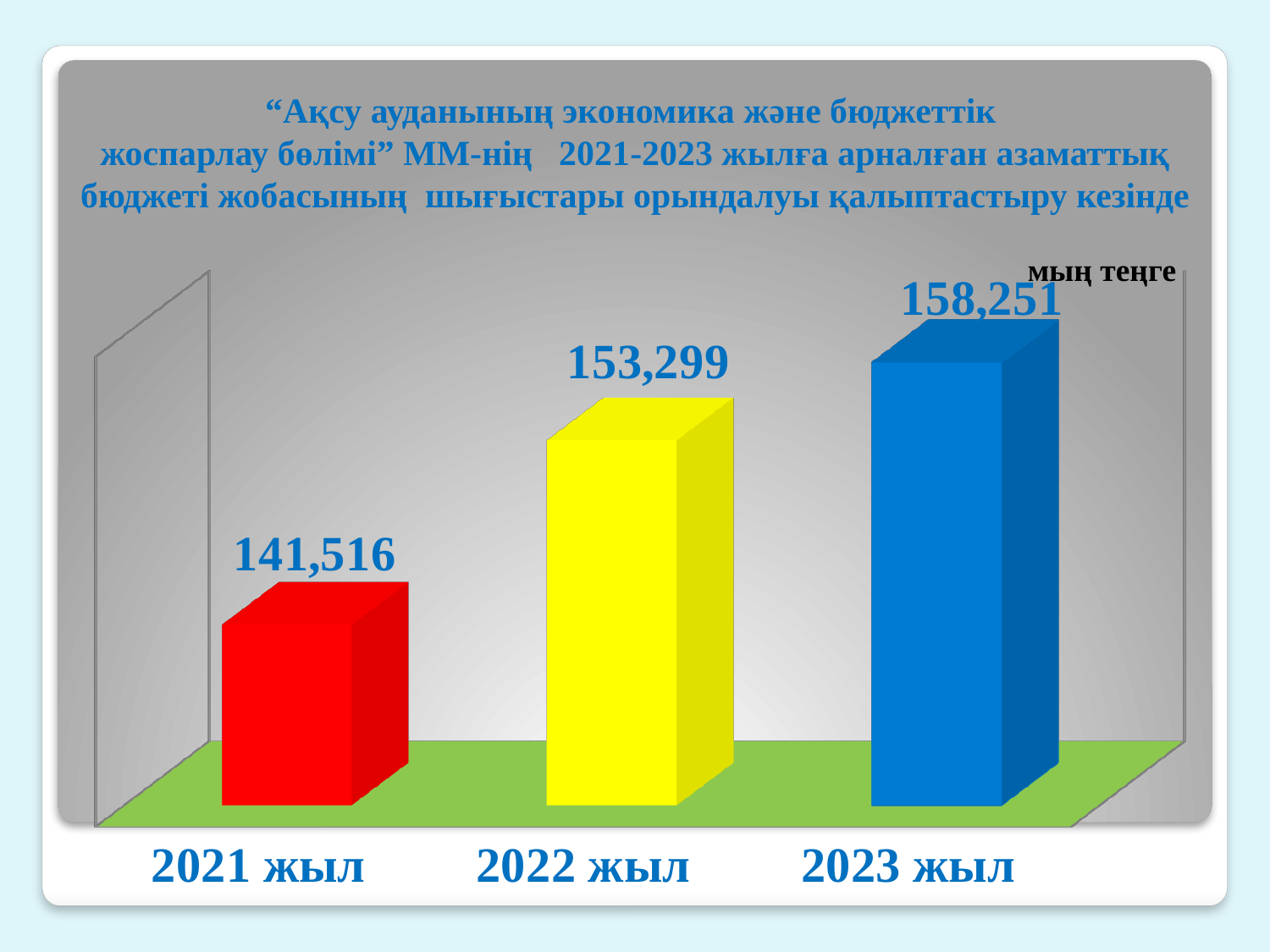
Do the values rise or fall from 2021 жыл to 2023 жыл? Rise What kind of chart is shown on the slide? Bar chart Which year has the lowest value? 2021 жыл What is the difference between the values for 2022 жыл and 2021 жыл? 11,783 What is the difference between the values for 2023 жыл and 2021 жыл? 16,735 Which year has the highest value? 2023 жыл What is the value for 2021 жыл? 141,516 Which is larger, the value for 2022 жыл or the value for 2021 жыл? 2022 жыл What is the value for 2023 жыл? 158,251 How many bars are shown in the chart? 3 What is the value for 2022 жыл? 153,299 What is the difference between the values for 2023 жыл and 2022 жыл? 4,952